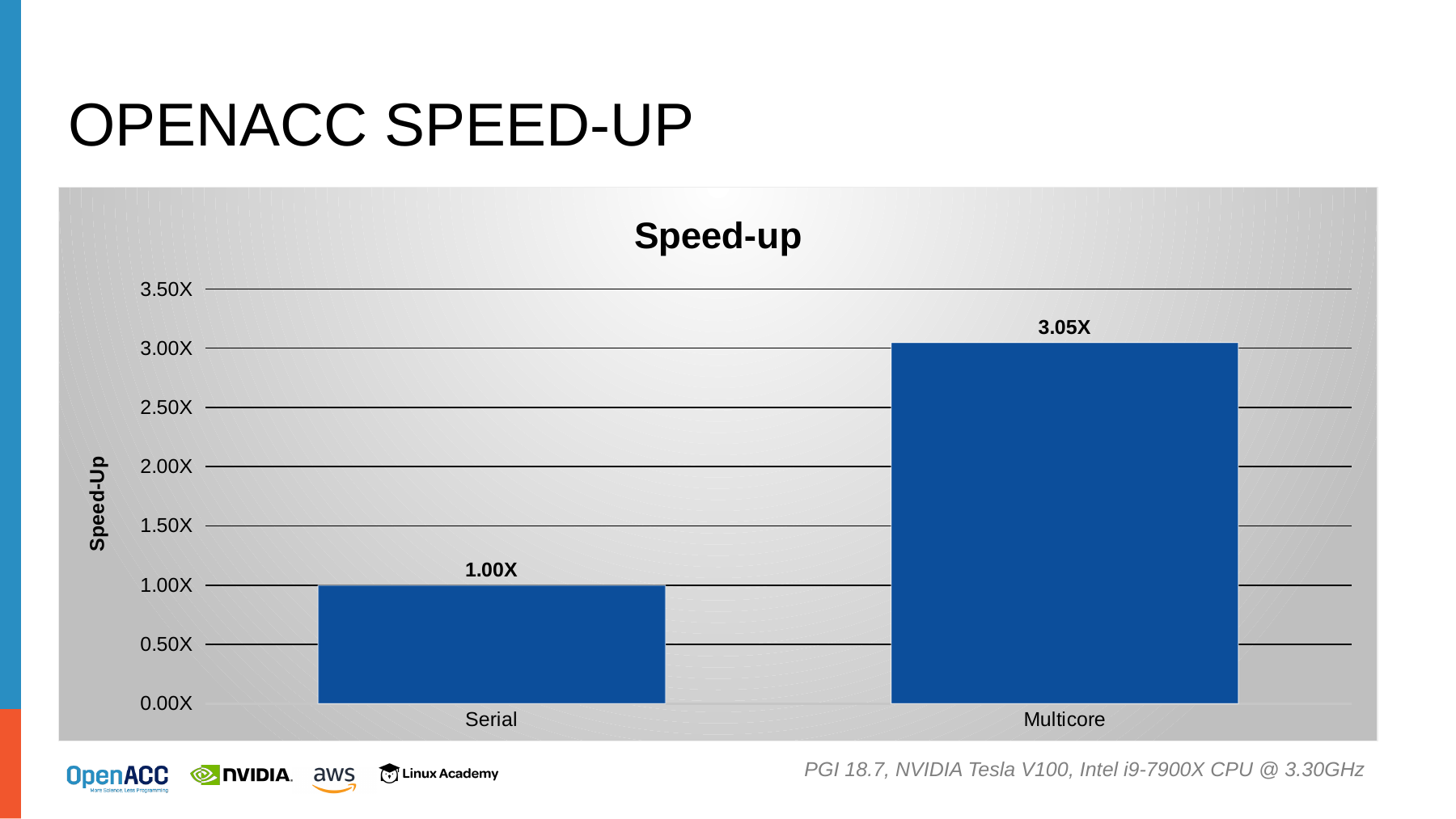
What is the difference between the Multicore and Serial speed-up values? 2.05X What is the title of the chart? Speed-up Is the value for Multicore greater or less than 3.00X? greater Which category has the lowest speed-up? Serial How many categories are shown on the x axis? 2 Which category has the highest speed-up? Multicore Is the value for Serial greater or less than 1.50X? less What is the speed-up value for Multicore? 3.05X What is the speed-up value for Serial? 1.00X Which has a larger speed-up, Serial or Multicore? Multicore What kind of chart is shown on the slide? bar chart What is the label of the vertical axis? Speed-Up